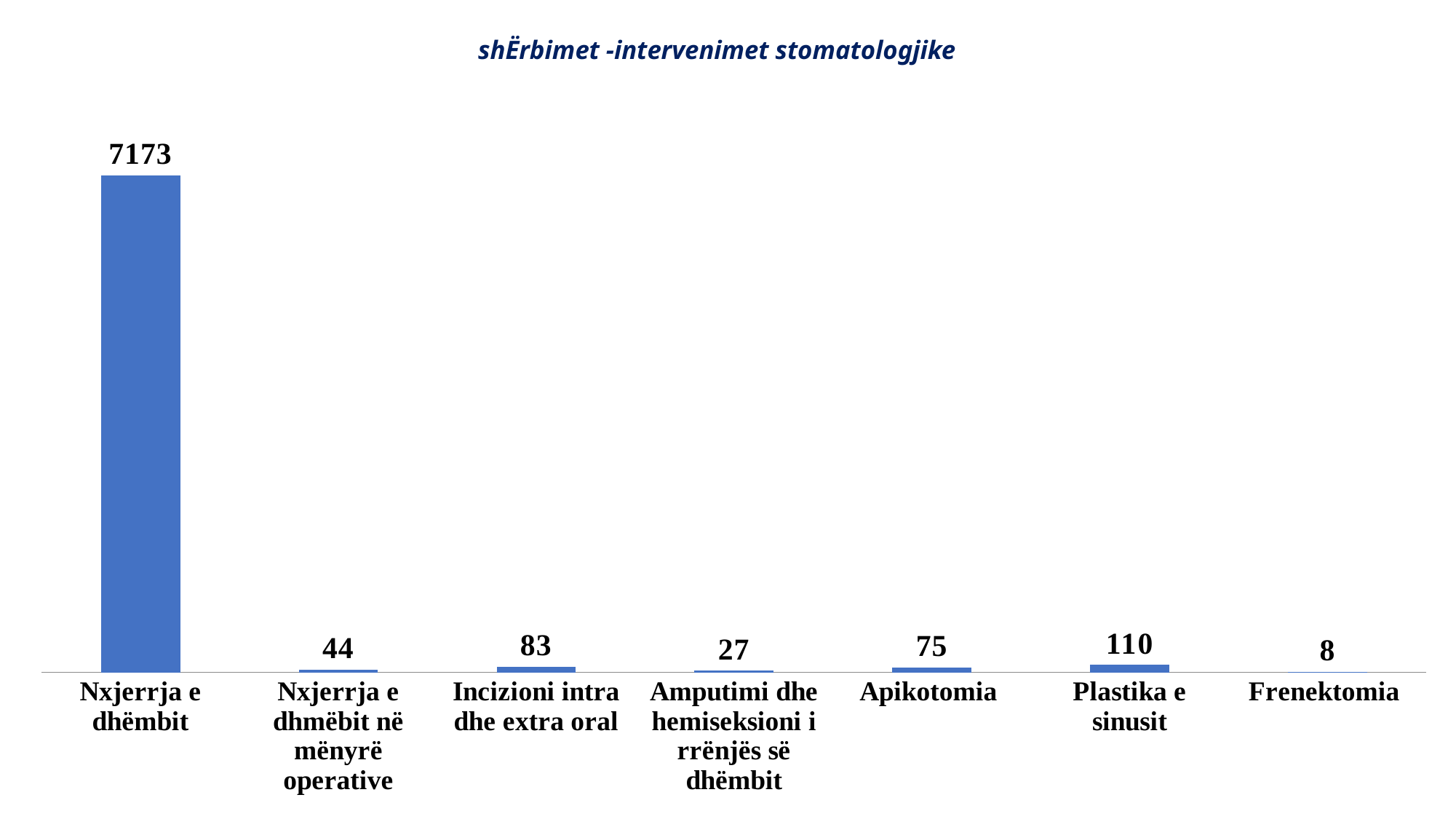
What is the value for Nxjerrja e dhëmbit? 7173 What is the value for Frenektomia? 8 What is the value for Plastika e sinusit? 110 What kind of chart is shown on the slide? Bar chart How many categories are shown on the chart? 7 What is the difference between the values for Plastika e sinusit and Apikotomia? 35 What is the value for Amputimi dhe hemiseksioni i rrënjës së dhëmbit? 27 Which is larger, the value for Apikotomia or the value for Incizioni intra dhe extra oral? Incizioni intra dhe extra oral Which category has the highest value? Nxjerrja e dhëmbit What is the title of the chart? shËrbimet -intervenimet stomatologjike What is the difference between the values for Incizioni intra dhe extra oral and Nxjerrja e dhmëbit në mënyrë operative? 39 Which category has the lowest value? Frenektomia